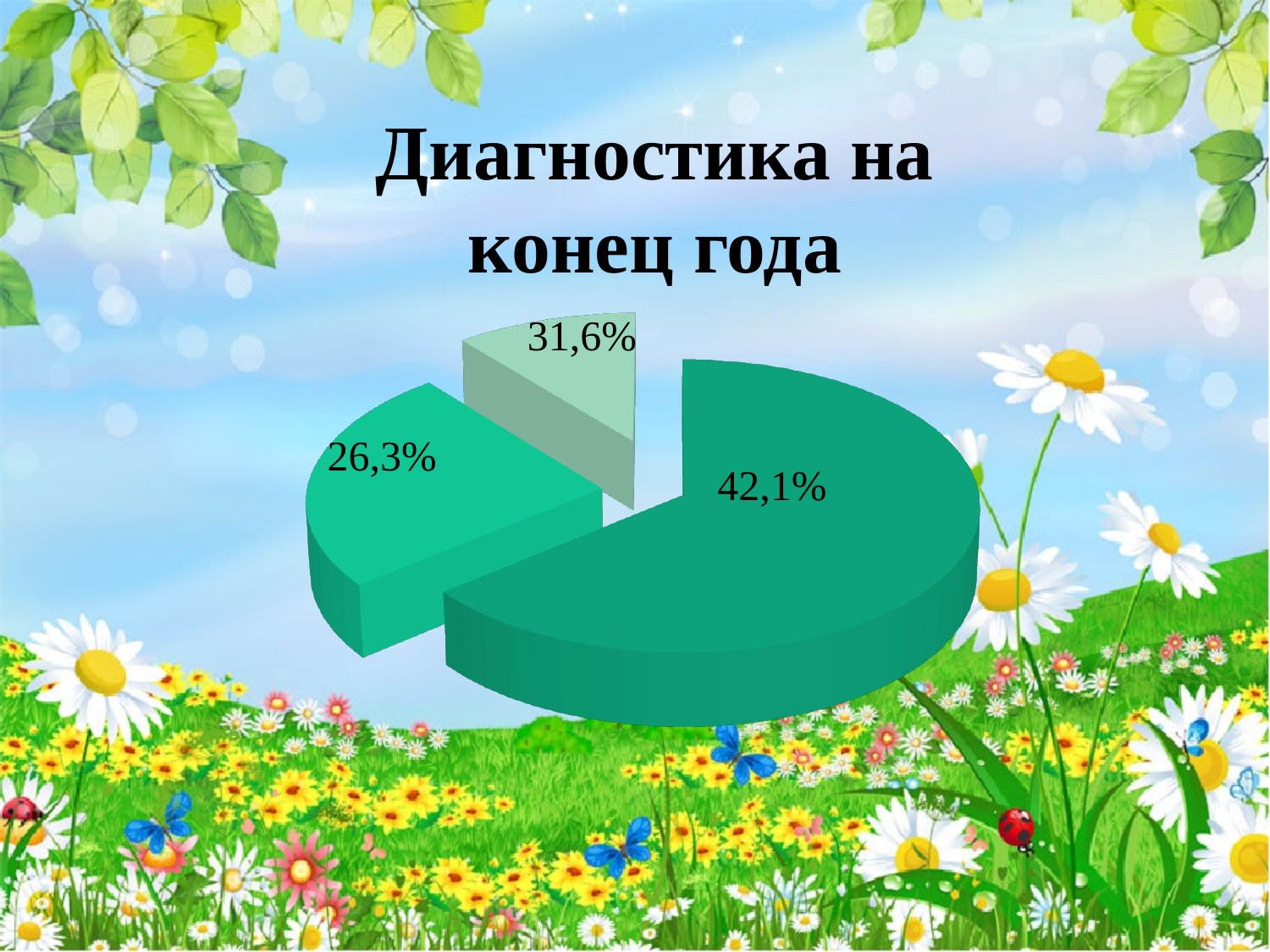
Which is larger: the slice labelled 31,6% or the slice labelled 26,3%? 31,6% What is the title of the chart on the slide? Диагностика на конец года What percentage is shown on the small, light green slice at the top of the pie chart? 31,6% What percentage is shown on the slice on the left side of the pie chart? 26,3% What is the difference between the largest slice (42,1%) and the smallest slice (26,3%)? 15,8% Does the pie chart have a legend? No What is the largest share shown in the pie chart? 42,1% What is the smallest share shown in the pie chart? 26,3% What kind of chart is shown on the slide? pie chart What percentage is shown on the largest, dark green slice of the pie chart? 42,1% Is the share of the largest slice greater or less than 40%? greater How many slices does the pie chart have? 3